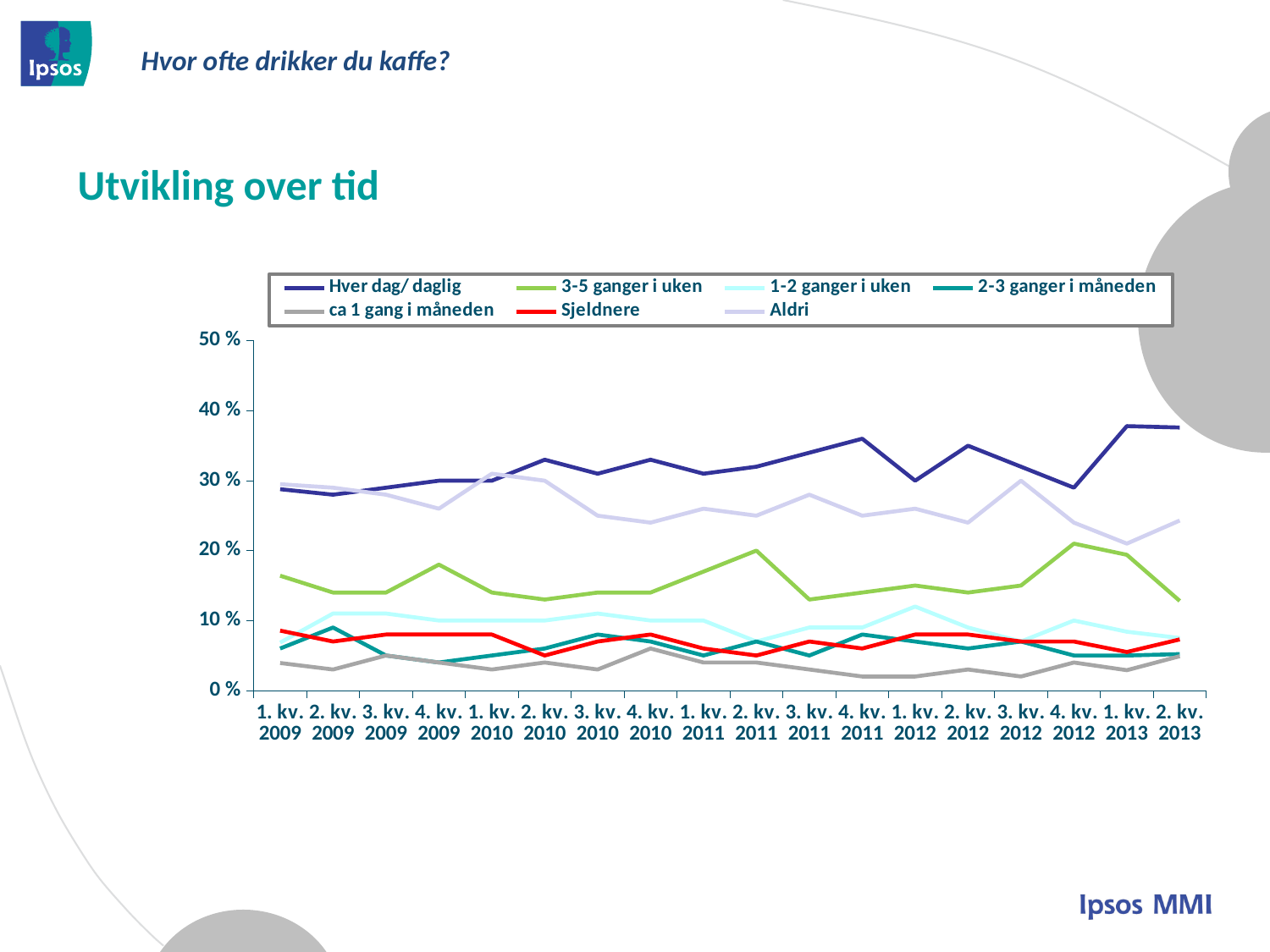
Which series has the highest value in 2. kv. 2013? Hver dag/ daglig Is the value for '3-5 ganger i uken' in 2. kv. 2011 greater or less than 10%? greater Is the value for 'Hver dag/ daglig' in 1. kv. 2013 greater or less than 30%? greater How many quarters are shown along the x axis? 18 What kind of chart is shown on the slide? line chart What colour is the 'Sjeldnere' line? red How many series does the legend list? 7 Which series has the lowest value in 4. kv. 2011? ca 1 gang i måneden Is the value for 'ca 1 gang i måneden' in 1. kv. 2012 greater or less than 10%? less Does the 'Hver dag/ daglig' series rise or fall overall from 1. kv. 2009 to 2. kv. 2013? rise In 2. kv. 2013, which is larger: '3-5 ganger i uken' or 'Aldri'? Aldri